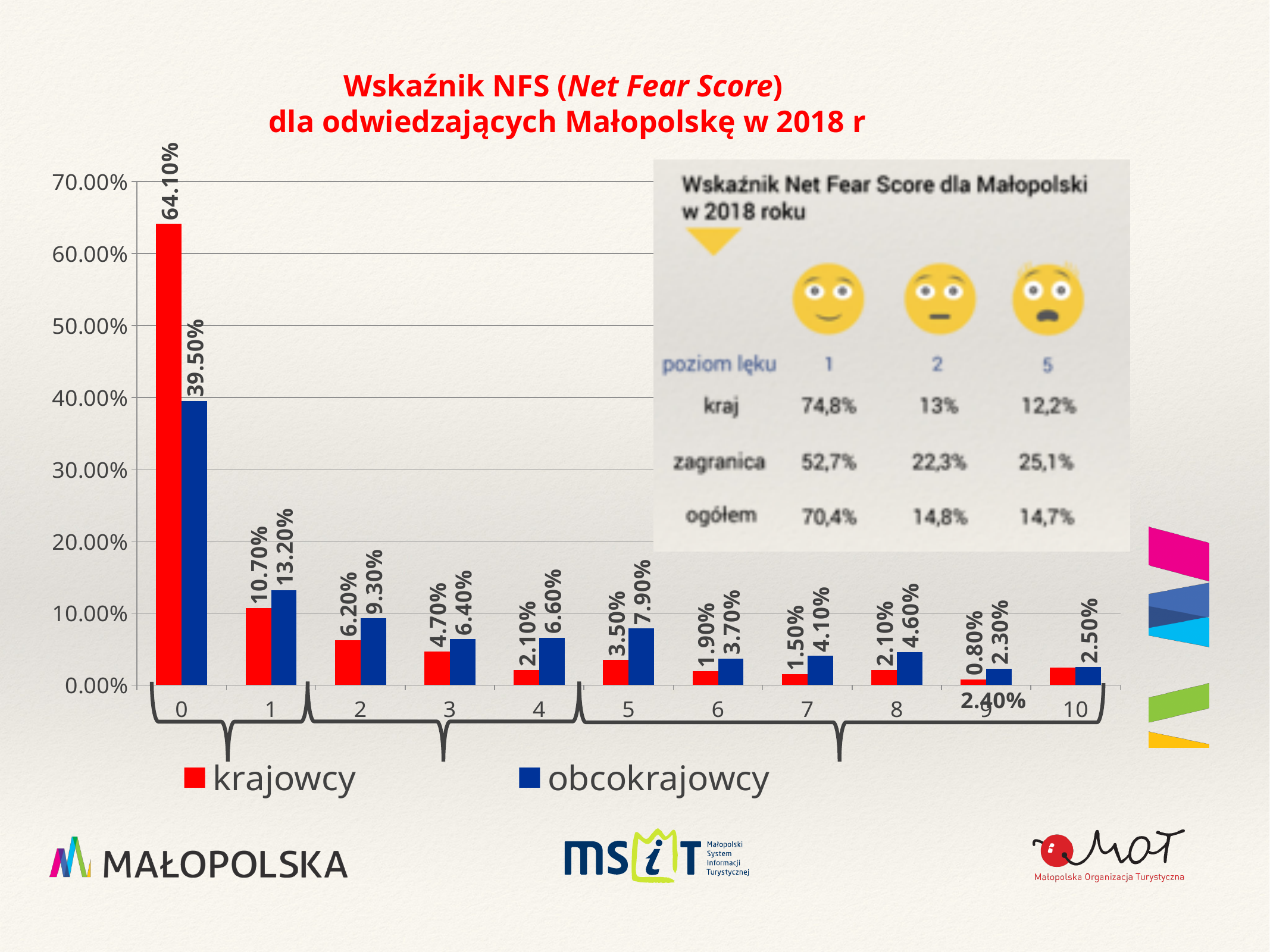
What is the value for obcokrajowcy at category 0? 39.50% Is the value for obcokrajowcy at category 0 greater or less than 40.00%? less Which category has the highest value for krajowcy? 0 What is the difference between the krajowcy and obcokrajowcy values at category 0? 24.60% What is the value for krajowcy at category 0? 64.10% What is the value for obcokrajowcy at category 5? 7.90% At category 1, which series has the larger value, krajowcy or obcokrajowcy? obcokrajowcy What is the value for krajowcy at category 9? 0.80% Which category has the lowest value for krajowcy? 9 How many series does the legend list? 2 How many categories are shown on the x axis of the bar chart? 11 What type of chart is shown on the slide? bar chart